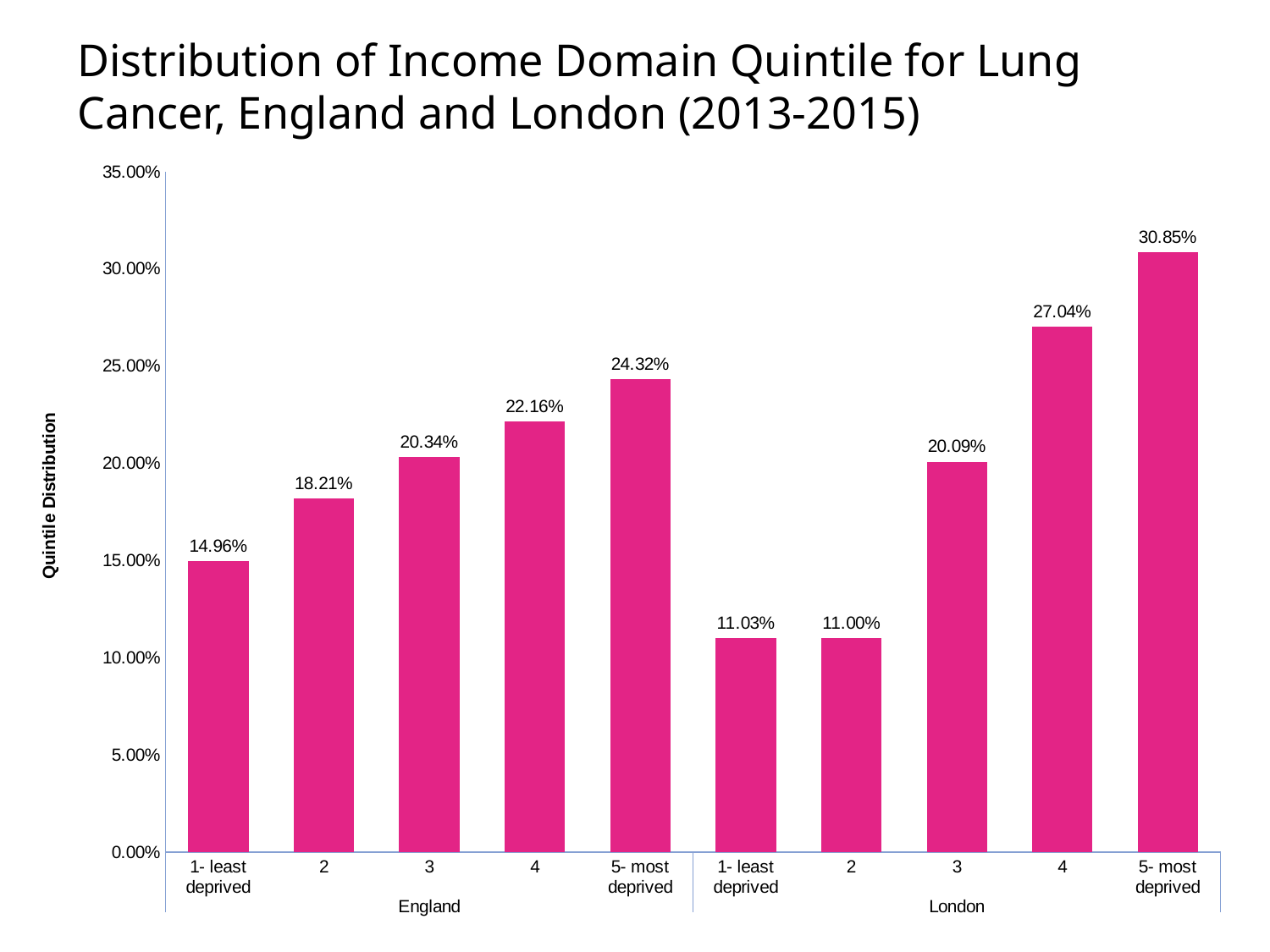
How many bars are plotted on the chart? 10 What is the value for the 1- least deprived quintile in England? 14.96% What is the value for quintile 3 in England? 20.34% Which bar has the lowest value on the chart? 2, London What is the label of the vertical axis? Quintile Distribution What is the difference between the 5- most deprived quintile in London and the 5- most deprived quintile in England? 6.53% Is the value for quintile 2 in England greater or less than 20.00%? less What is the value for the 5- most deprived quintile in London? 30.85% Which bar has the highest value on the chart? 5- most deprived, London What kind of chart is shown on the slide? Bar chart Which is larger: quintile 4 in England or quintile 4 in London? 4 in London Do the values for England rise or fall from the 1- least deprived quintile to the 5- most deprived quintile? Rise